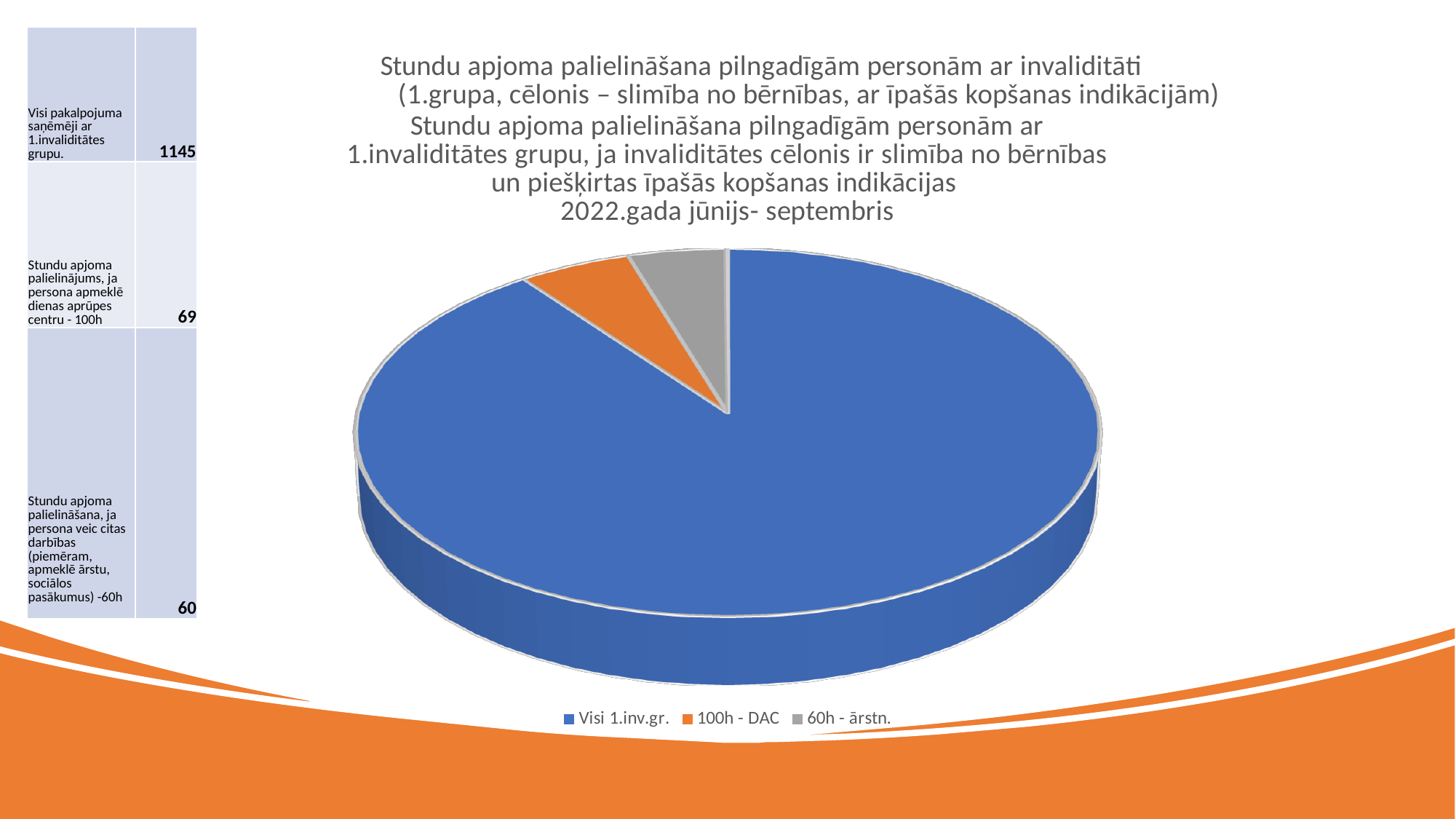
Using the values in the table, what is the difference between the value for 100h - DAC and the value for 60h - ārstn.? 9 Using the values in the table, what is the difference between the value for Visi 1.inv.gr. and the value for 100h - DAC? 1076 Which period does the chart title say the data covers? 2022.gada jūnijs- septembris Which slice of the pie chart is the largest? Visi 1.inv.gr. How many entries does the legend of the pie chart list? 3 Which is larger in the pie chart, the slice for Visi 1.inv.gr. or the slice for 100h - DAC? Visi 1.inv.gr. According to the table on the slide, what is the value for all service recipients with 1st disability group (Visi 1.inv.gr.)? 1145 How many slices does the pie chart have? 3 According to the table on the slide, what is the value for the 100h day care centre (DAC) increase? 69 According to the table on the slide, what is the value for the 60h increase for other activities (ārstn.)? 60 What kind of chart is shown on the slide? pie chart What colour is the slice for 100h - DAC in the pie chart? orange